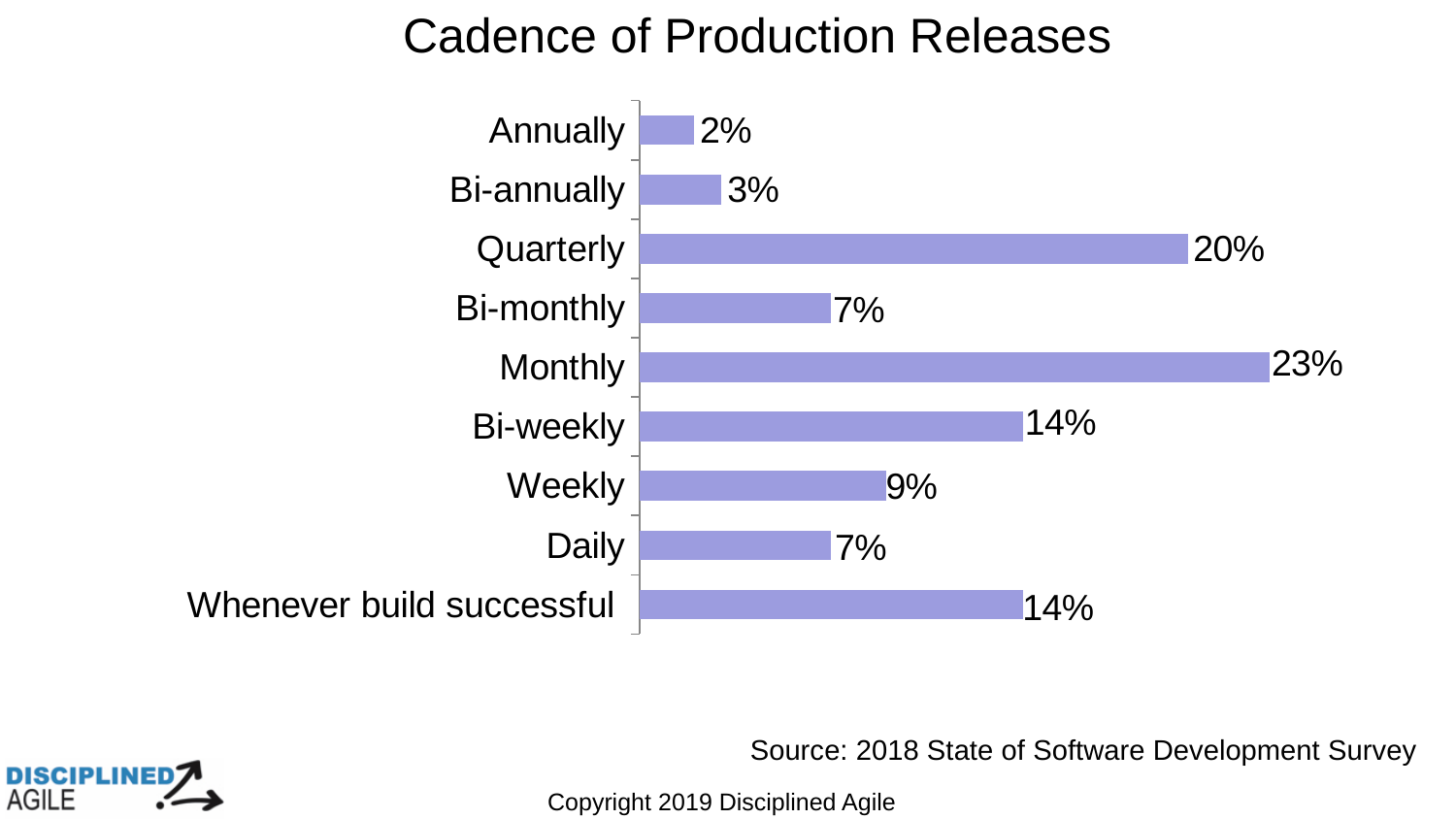
Which release cadence has the highest percentage? Monthly What is the value for Whenever build successful? 14% What is the title of the chart? Cadence of Production Releases What is the value for Quarterly? 20% What kind of chart is shown on the slide? Bar chart What is the difference between the Bi-weekly and Weekly values? 5% What is the difference between the Monthly and Quarterly values? 3% What percentage of respondents release to production monthly? 23% Which is larger, the value for Weekly or the value for Daily? Weekly Which is larger, the value for Bi-annually or the value for Bi-monthly? Bi-monthly How many release cadence categories are shown in the chart? 9 Which release cadence has the lowest percentage? Annually